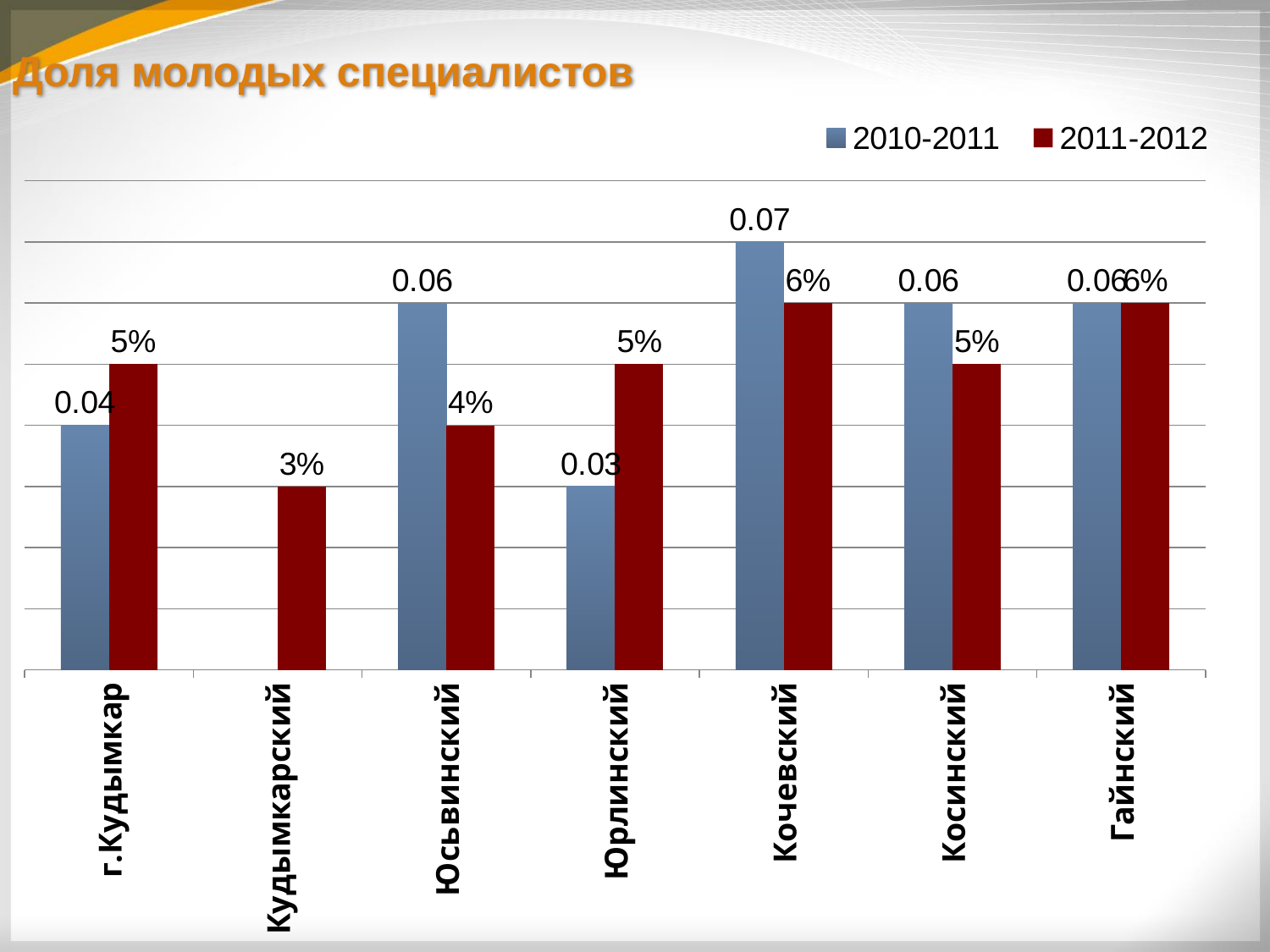
What is the value for Юсьвинский in the 2011-2012 series? 4% Which is larger for г.Кудымкар: the 2010-2011 value or the 2011-2012 value? 2011-2012 Which is larger for Юсьвинский: the 2010-2011 value or the 2011-2012 value? 2010-2011 What is the value for Кочевский in the 2010-2011 series? 0.07 Which category has the highest value in the 2010-2011 series? Кочевский What is the value for Кудымкарский in the 2011-2012 series? 3% How many categories are shown on the x axis? 7 How many series does the legend list? 2 What is the title of the slide? Доля молодых специалистов What kind of chart is shown on the slide? Bar chart Which category has the lowest value in the 2011-2012 series? Кудымкарский What is the value for Юрлинский in the 2010-2011 series? 0.03